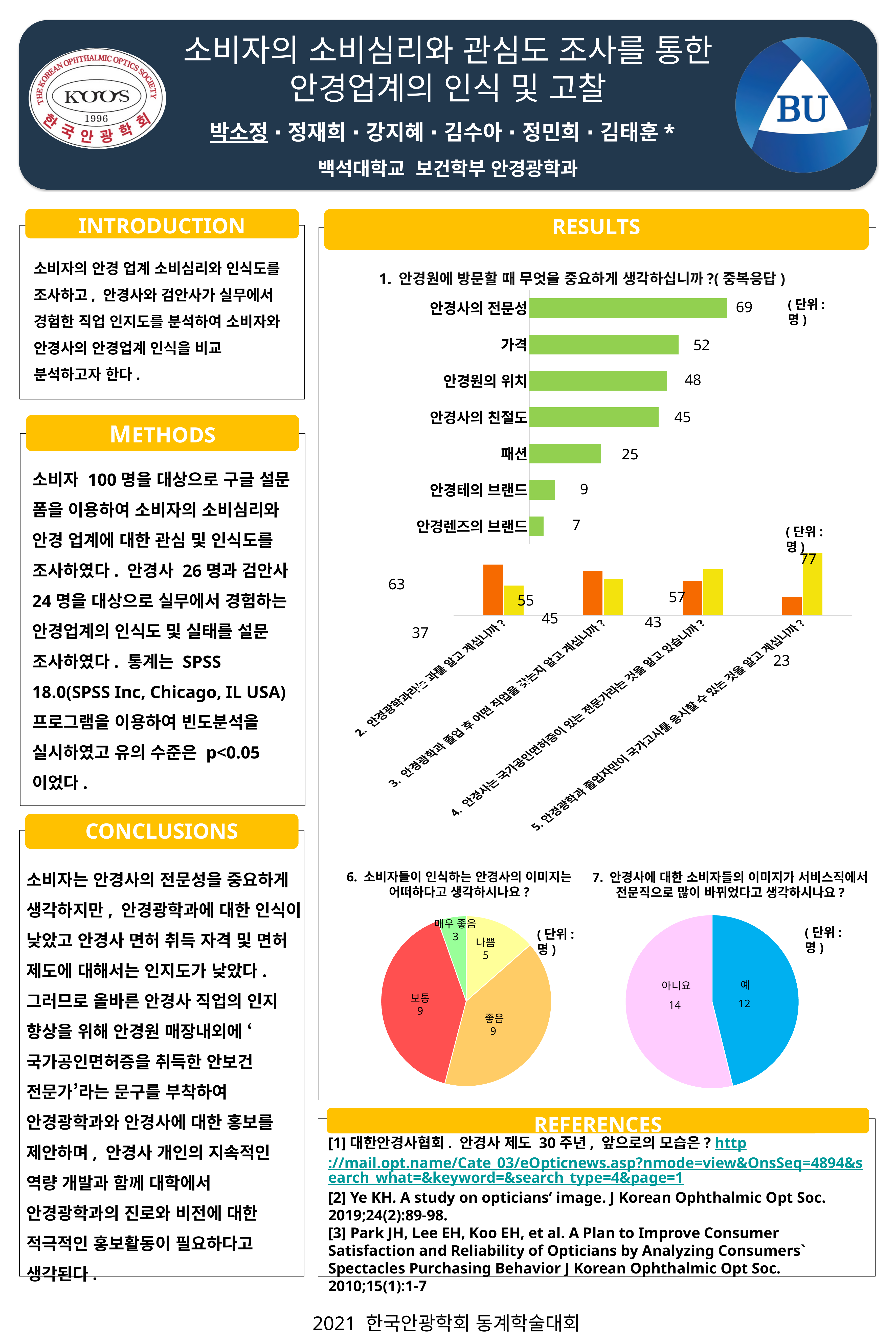
In the chart for question 1, what is the difference between 안경원의 위치 and 안경사의 친절도? 3 In the pie chart for question 7, what is the total of 예 and 아니요? 26 In the pie chart for question 7 (안경사에 대한 소비자들의 이미지가 서비스직에서 전문직으로 많이 바뀌었다고 생각하시나요), which is larger, 예 or 아니요? 아니요 What kind of chart is used for question 1? bar chart In the pie chart for question 6 (소비자들이 인식하는 안경사의 이미지), what is the value for 나쁨? 5 In the chart for question 1 (안경원에 방문할 때 무엇을 중요하게 생각하십니까), what is the value for 안경사의 전문성? 69 In the pie chart for question 6, which slice is the smallest? 매우 좋음 In the chart for question 1, which category has the highest value? 안경사의 전문성 In the chart for question 1, which category has the lowest value? 안경렌즈의 브랜드 In the chart for question 1, what is the value for 가격? 52 In the chart for question 1, how many categories are shown? 7 In the chart for question 1, what is the value for 패션? 25